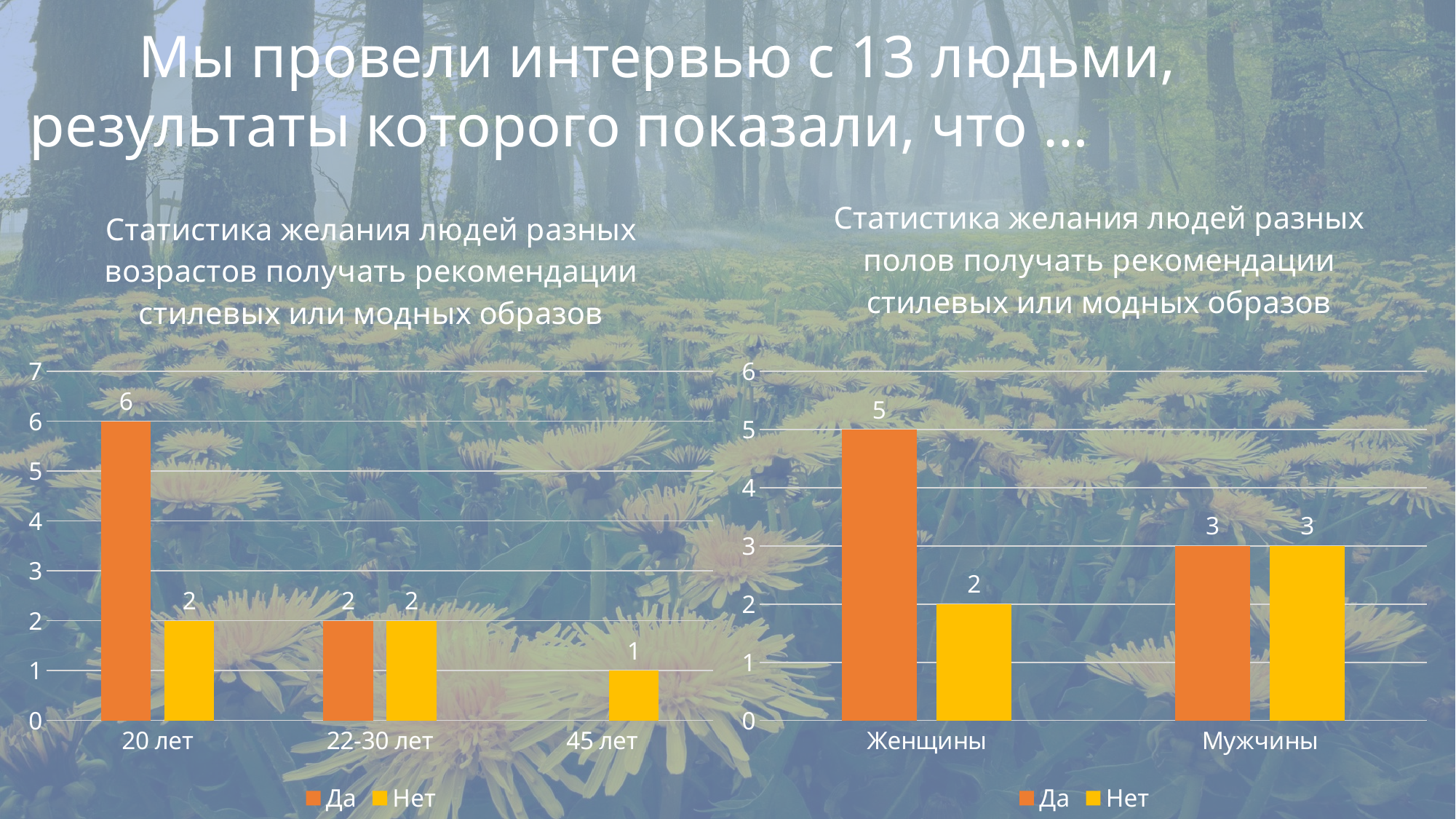
In the right chart (genders), which is larger for "Женщины": "Да" or "Нет"? Да In the left chart (ages), what is the value of "Нет" for "45 лет"? 1 In the left chart (ages), how many age categories are shown on the x axis? 3 In the left chart (ages), what is the value of "Да" for "20 лет"? 6 In the right chart (genders), what is the value of "Да" for "Женщины"? 5 In the right chart (genders), what is the difference between "Да" for "Женщины" and "Да" for "Мужчины"? 2 In the right chart (genders), what is the value of "Нет" for "Мужчины"? 3 In the left chart (ages), what is the difference between "Да" and "Нет" for "20 лет"? 4 How many series does the legend of the right chart (genders) list? 2 In the left chart (ages), what is the value of "Нет" for "22-30 лет"? 2 In the left chart (ages), which age group has the highest "Да" value? 20 лет What type of chart is the left chart (ages)? Bar chart